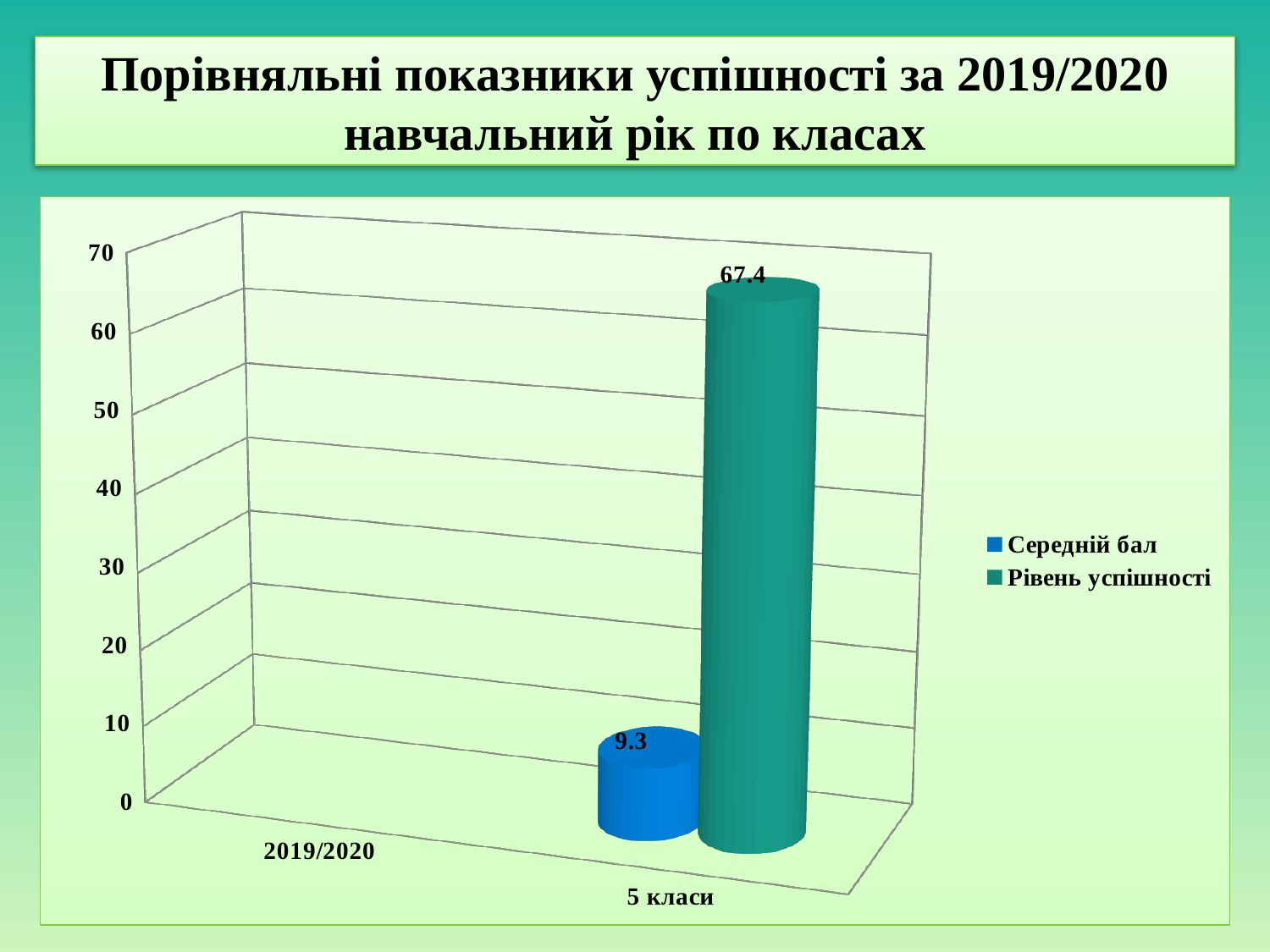
What kind of chart is shown on the slide? Bar chart How many categories are shown on the x axis of the chart? 2 What is the value of "Середній бал" for 5 класи? 9.3 Is the value for "Середній бал" greater or less than 10? less Which series is shown in blue in the legend? Середній бал Is the value for "Рівень успішності" greater or less than 60? greater What is the value of "Рівень успішності" for 5 класи? 67.4 Which series has the higher value for 5 класи, "Середній бал" or "Рівень успішності"? Рівень успішності How many series does the legend list? 2 What is the highest value shown on the vertical axis of the chart? 70 What is the difference between "Рівень успішності" and "Середній бал" for 5 класи? 58.1